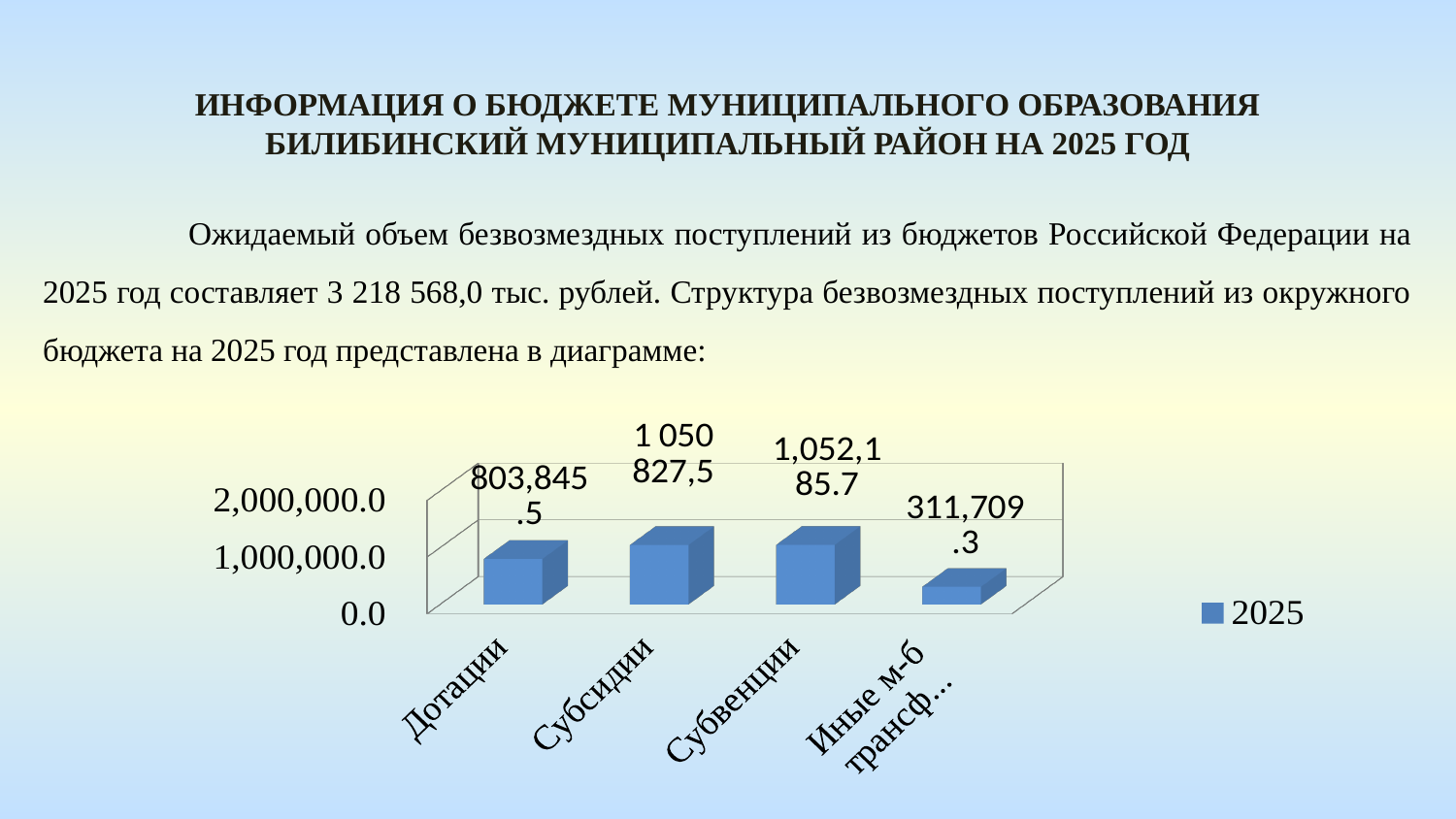
What kind of chart is shown on the slide? bar chart Is the value for Дотации greater or less than 1,000,000.0? less What is the value for Дотации? 803,845.5 What is the value for the fourth category, Иные м-б трансф...? 311,709.3 Which category has the highest value? Субвенции Which category has the lowest value? Иные м-б трансф... How many categories are shown on the x axis? 4 Which is larger, the value for Дотации or the value for Субсидии? Субсидии How many series does the legend list? 1 What is the difference between the values for Дотации and Иные м-б трансф...? 492,136.2 What is the value for Субсидии? 1 050 827,5 What is the value for Субвенции? 1,052,185.7